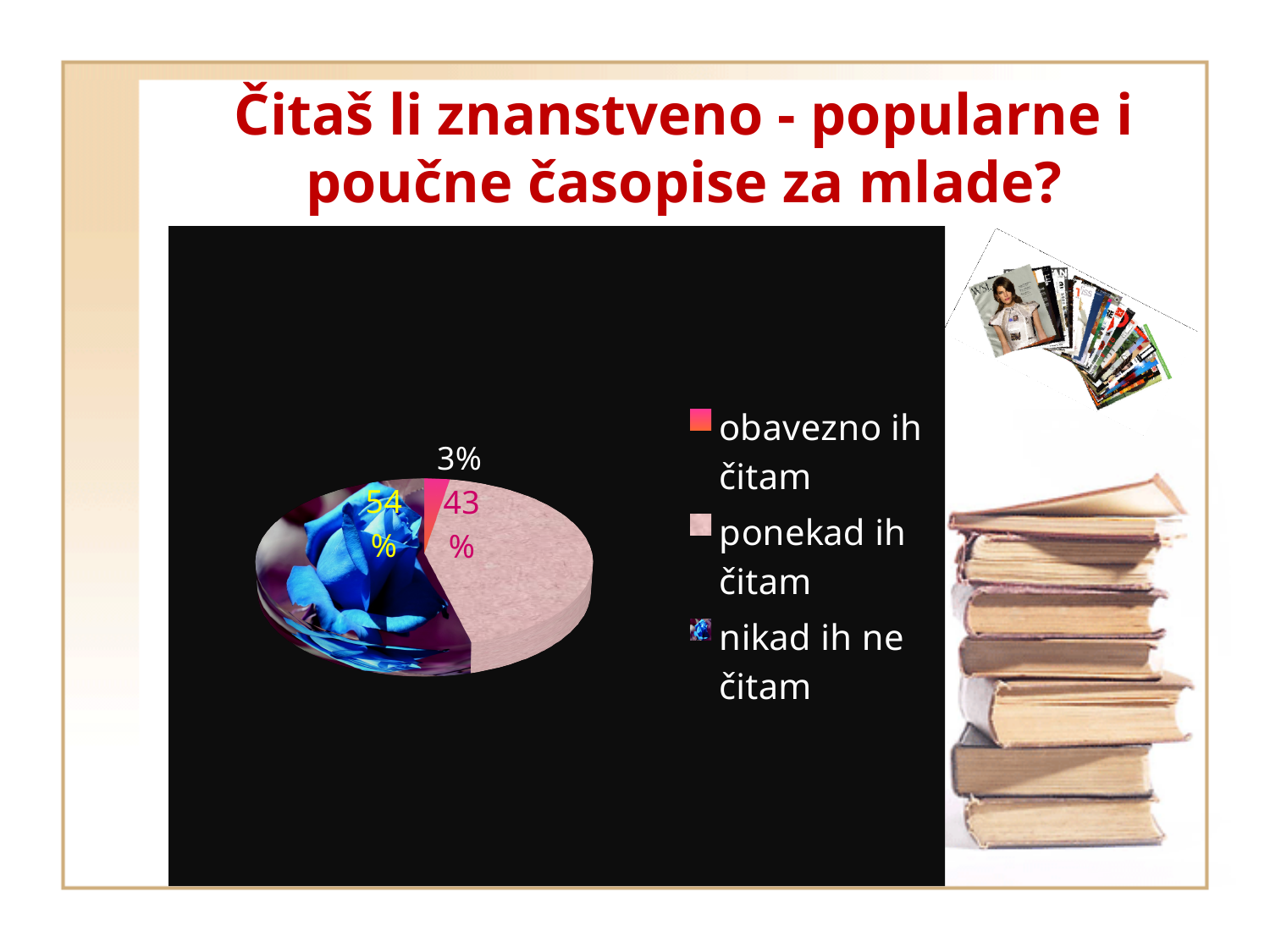
How many entries does the legend of the pie chart list? 3 What is the title of the slide containing the pie chart? Čitaš li znanstveno - popularne i poučne časopise za mlade? What is the first entry listed in the legend of the pie chart? obavezno ih čitam What is the largest percentage printed on the pie chart? 54% How many slices does the pie chart have? 3 Which category has the smallest share of the pie? obavezno ih čitam Which is larger: the share for 'obavezno ih čitam' or the share for 'ponekad ih čitam'? ponekad ih čitam What is the difference between the 54% slice and the 3% slice? 51% What percentage is shown for 'nikad ih ne čitam'? 54% What percentage is shown for 'ponekad ih čitam'? 43% What percentage is shown for 'obavezno ih čitam'? 3% What kind of chart is shown on the slide? pie chart